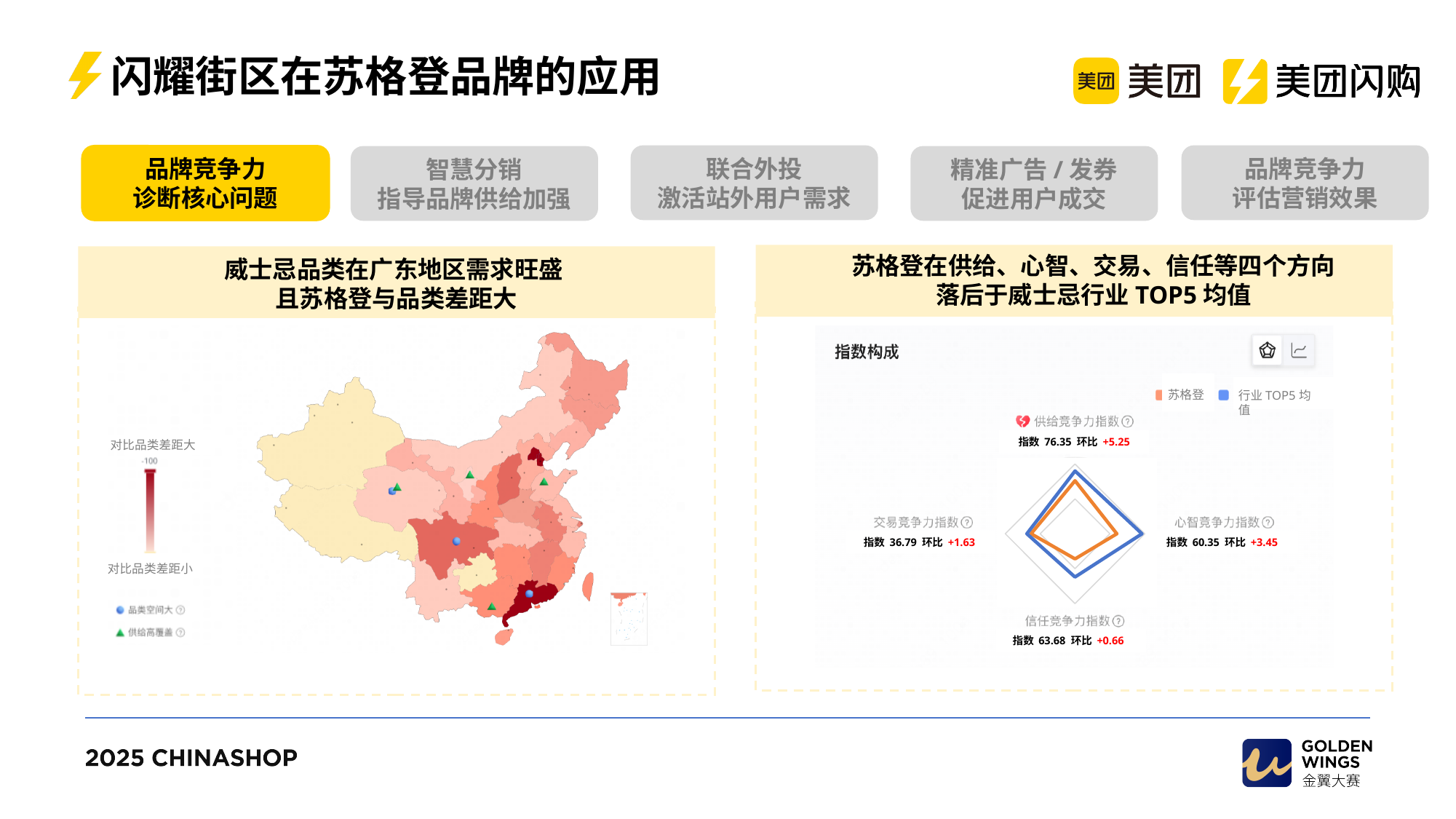
On the right chart (指数构成), which of the four indices has the highest 指数 value? 供给竞争力指数 On the right chart (指数构成), how many index dimensions (axes) are plotted? 4 On the right chart (指数构成), which series is drawn in orange according to the legend? 苏格登 On the right chart (指数构成), what is the difference between the 指数 values of 供给竞争力指数 and 交易竞争力指数? 39.56 On the right chart (指数构成), which of the four indices has the lowest 指数 value? 交易竞争力指数 On the right chart (指数构成), what is the 指数 value for 供给竞争力指数? 76.35 What kind of chart is shown on the right side of the slide under 指数构成? Radar chart On the right chart (指数构成), what is the 指数 value for 交易竞争力指数? 36.79 On the right chart (指数构成), what is the 环比 value shown for 心智竞争力指数? +3.45 On the right chart (指数构成), how many series does the legend list? 2 On the right chart (指数构成), what is the 环比 value shown for 信任竞争力指数? +0.66 On the right chart (指数构成), which has a larger 指数 value: 心智竞争力指数 or 信任竞争力指数? 信任竞争力指数